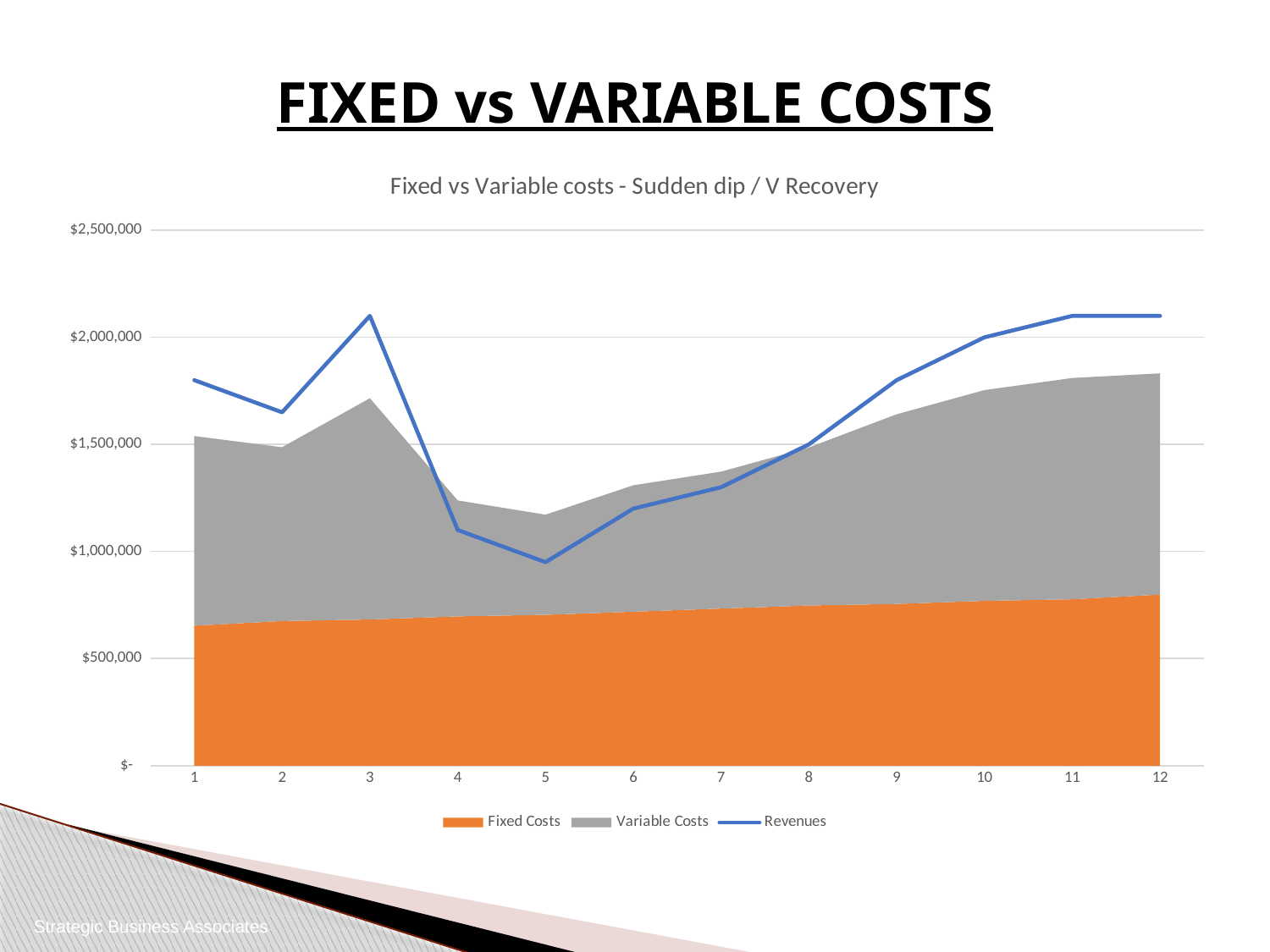
Is the value for Revenues in period 1 greater or less than $1,500,000? greater Which series is shown in orange? Fixed Costs Do Fixed Costs rise or fall from period 1 to period 12? rise Which is larger, Revenues in period 5 or Revenues in period 9? period 9 In which period are Revenues lowest? 5 How many periods are shown on the x axis? 12 Is the value for Revenues in period 3 greater or less than $2,000,000? greater How many series does the legend list? 3 Is the value for Fixed Costs in period 12 greater or less than $1,000,000? less What kind of chart is this? Stacked area chart with a line What is the title of the chart? Fixed vs Variable costs - Sudden dip / V Recovery